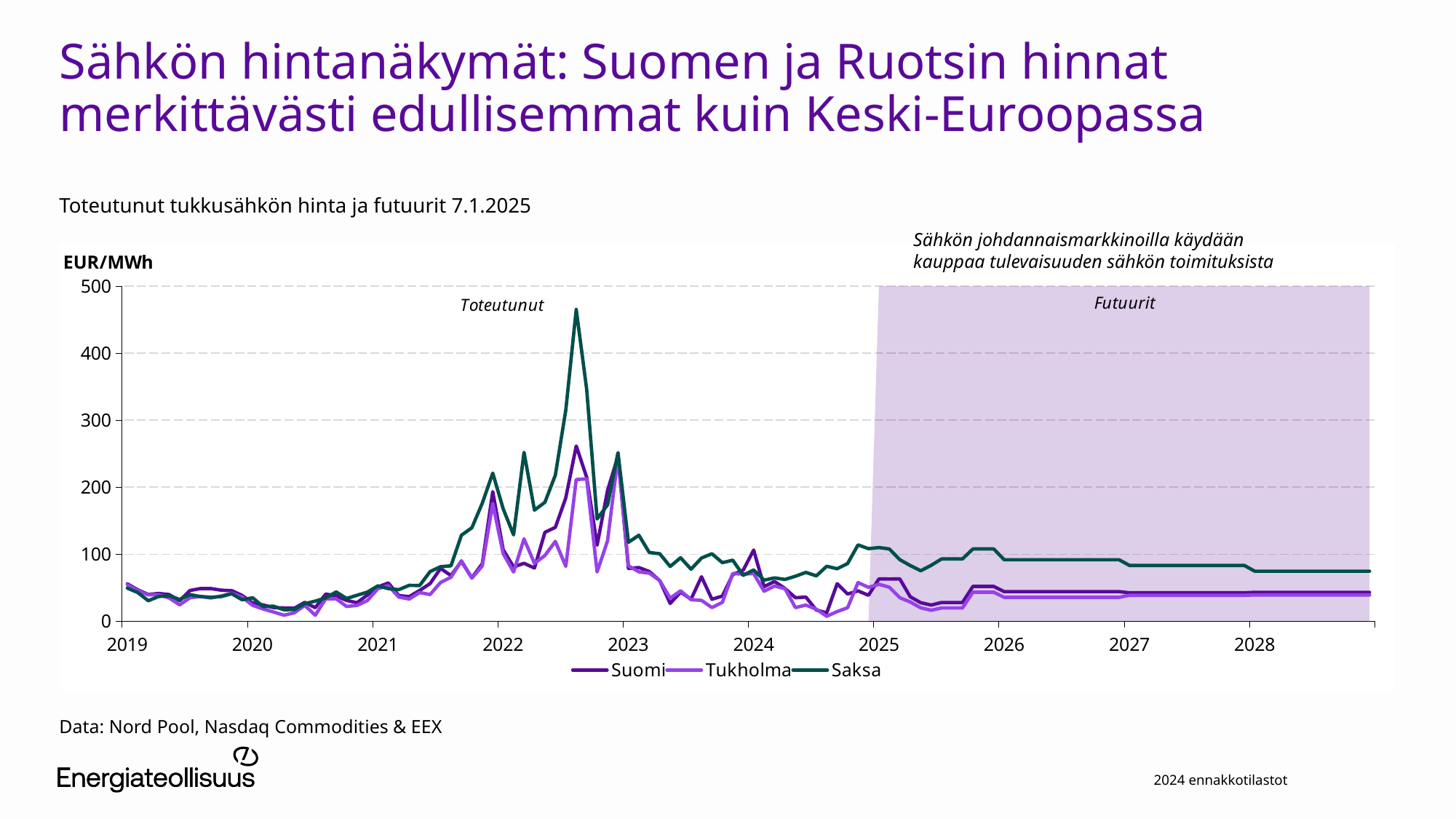
Is the peak value for Tukholma in 2022 greater or less than 300? less Which series reaches the highest peak in 2022? Saksa What kind of chart is shown on the slide? Line chart Is the futures value for Suomi in 2028 greater or less than 100? less In the futures period for 2028, which is higher, Saksa or Suomi? Saksa Which series are listed in the legend? Suomi, Tukholma, Saksa Is the peak value for Saksa in 2022 greater or less than 400? greater Which series has the lowest values in the futures period around 2026? Tukholma How many series does the legend list? 3 What unit is shown on the y axis? EUR/MWh